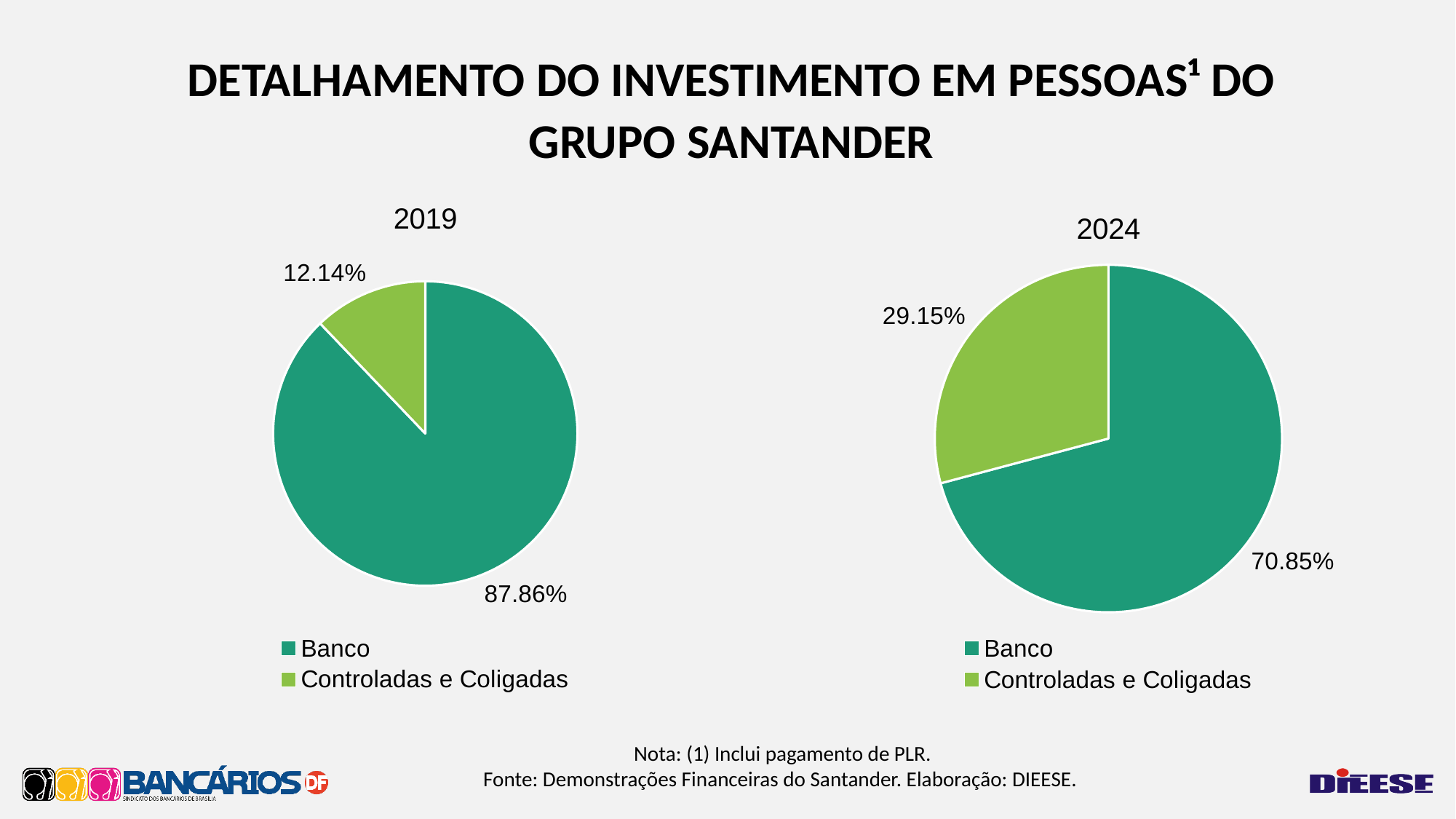
What is the difference between the Banco share in 2019 and the Banco share in 2024? 17.01% How many slices does the 2019 pie chart have? 2 In the 2024 pie chart, which slice is the largest? Banco Is the Controladas e Coligadas share larger in the 2019 chart or the 2024 chart? 2024 What is the title of the slide? DETALHAMENTO DO INVESTIMENTO EM PESSOAS¹ DO GRUPO SANTANDER How many entries does the legend of the 2024 chart list? 2 In the 2019 pie chart, what share does Controladas e Coligadas have? 12.14% In the 2024 pie chart, what share does Banco have? 70.85% In the 2019 pie chart, which slice is the smallest? Controladas e Coligadas In the 2019 pie chart, what share does Banco have? 87.86% In the 2024 pie chart, what share does Controladas e Coligadas have? 29.15% What type of chart is used for the 2019 data? Pie chart